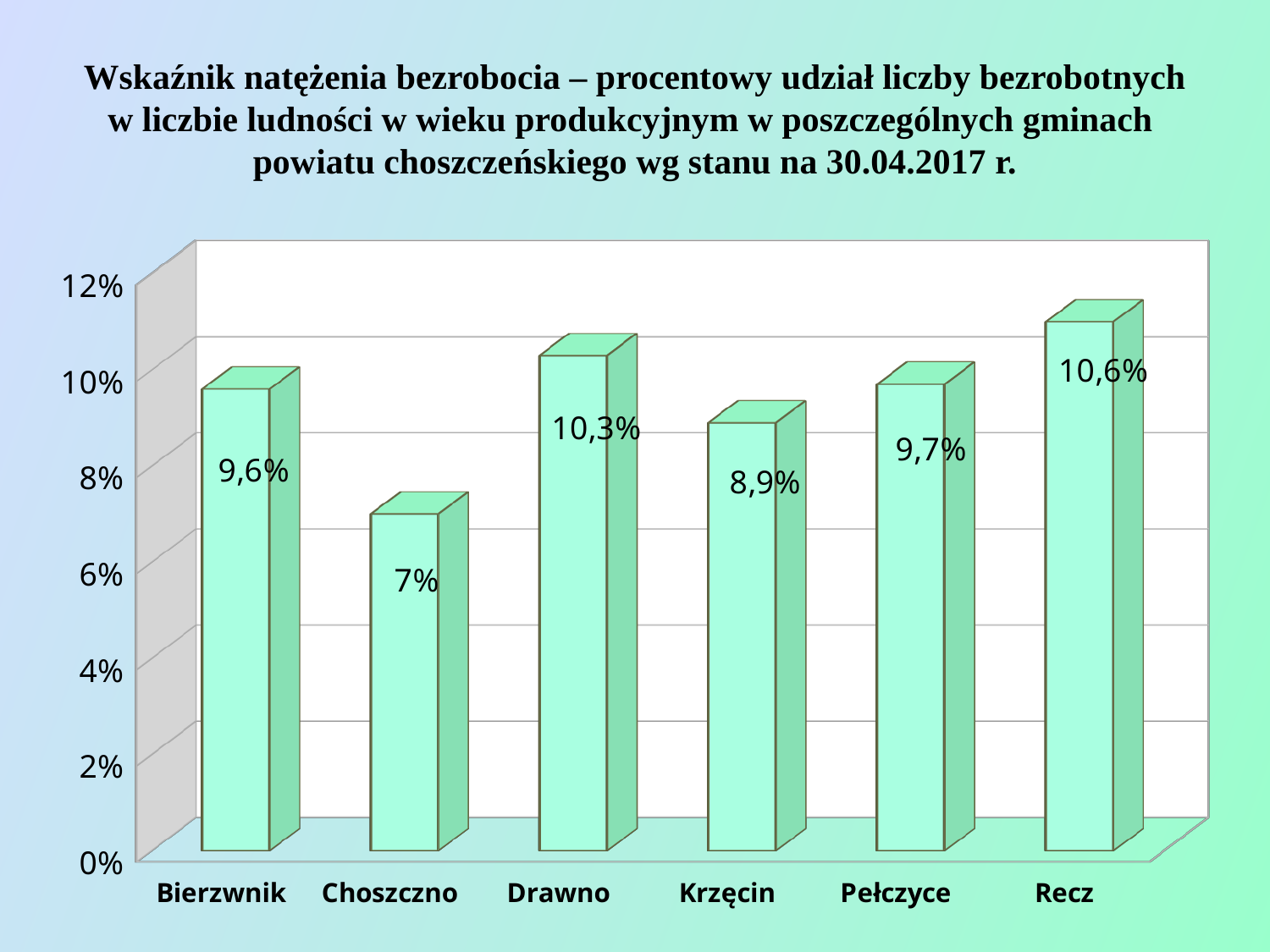
How many gminas are shown on the chart? 6 Which gmina has the highest value? Recz Which gmina has the lowest value? Choszczno What kind of chart is shown on the slide? bar chart What is the value for Krzęcin? 8,9% Is the value for Krzęcin greater or less than 10%? less Which is larger, the value for Drawno or the value for Pełczyce? Drawno What is the value for Bierzwnik? 9,6% What is the value for Drawno? 10,3% What is the value for Pełczyce? 9,7% What is the value for Choszczno? 7% What is the difference between the values for Recz and Choszczno? 3,6%